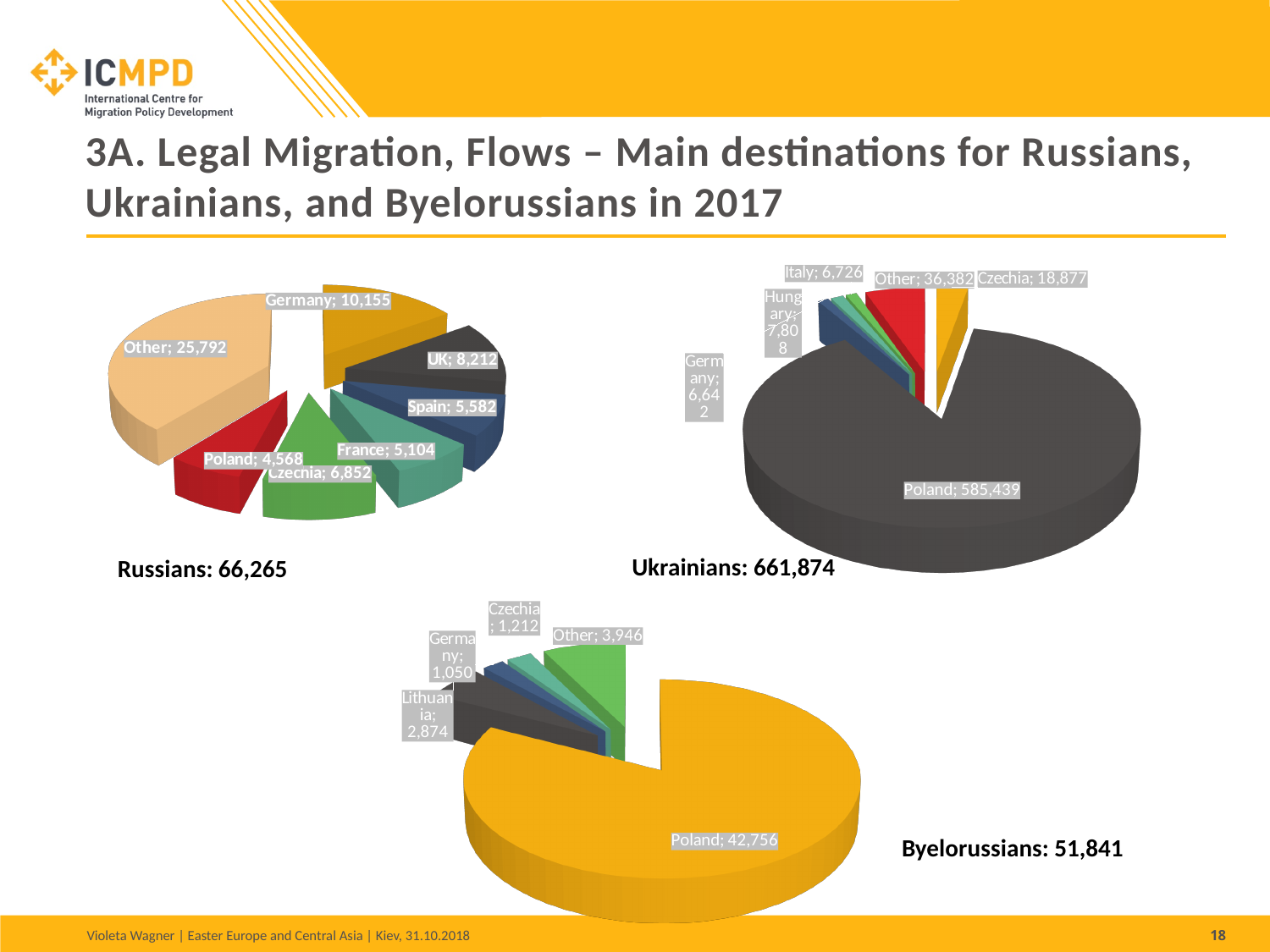
In the Russians pie chart, which category has the smallest value? Poland In the Byelorussians pie chart, what is the difference between the values for Poland and Other? 38,810 In the Russians pie chart, what is the value for Germany? 10,155 In the Ukrainians pie chart, what is the difference between the values for Czechia and Italy? 12,151 How many pie charts are shown on the slide? 3 In the Byelorussians pie chart, what is the value for Lithuania? 2,874 In the Ukrainians pie chart, what is the value for Hungary? 7,808 In the Russians pie chart, how many slices are there? 7 In the Ukrainians pie chart, what is the value for Poland? 585,439 In the Russians pie chart, which category has the largest value? Other In the Byelorussians pie chart, which is larger, Czechia or Germany? Czechia What kind of chart is used for the Ukrainians data? Pie chart